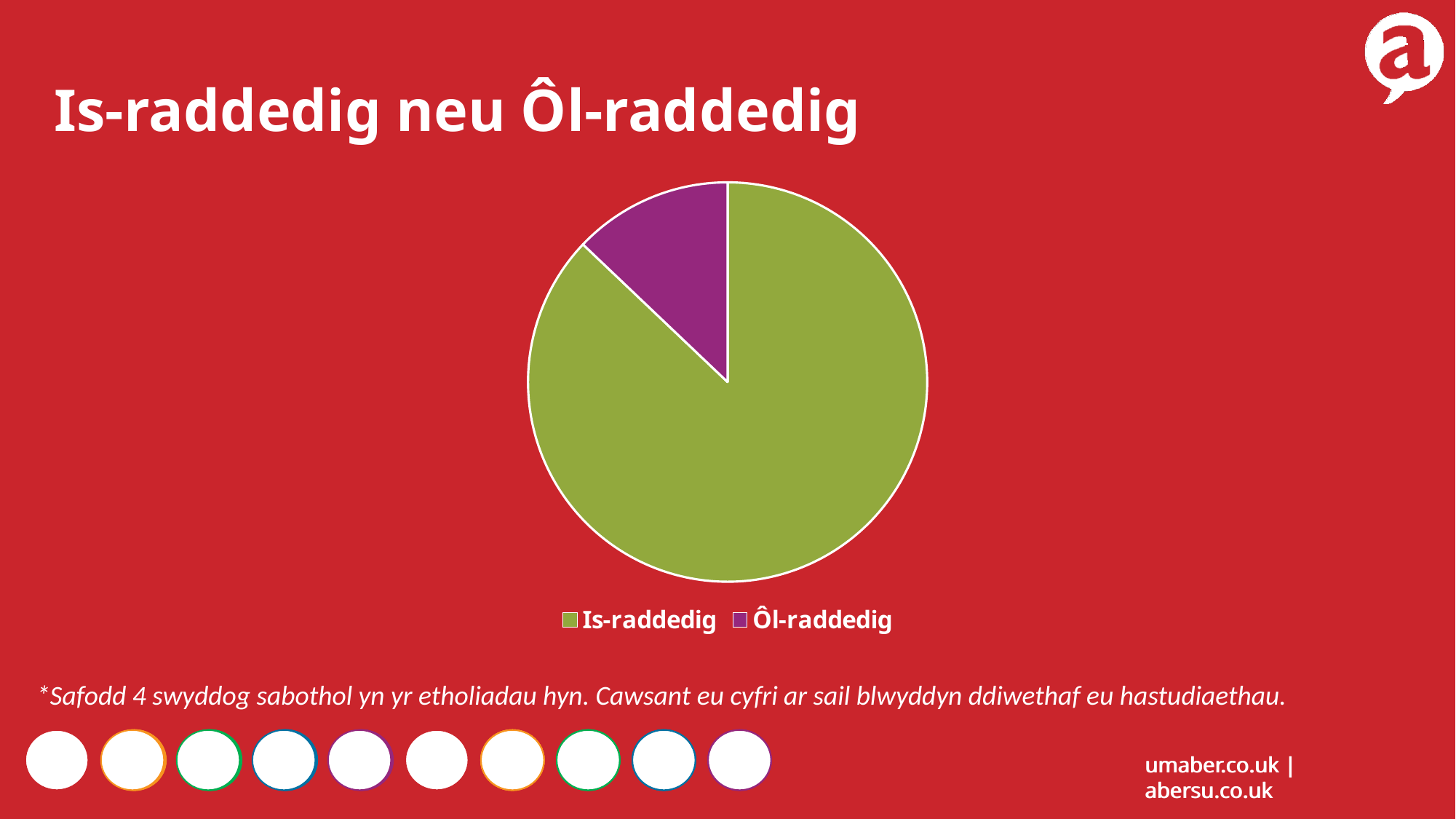
Which category has the largest slice of the pie chart? Is-raddedig How many entries does the legend of the pie chart list? 2 What kind of chart is shown on the slide? pie chart How many slices does the pie chart have? 2 Which slice is larger, Is-raddedig or Ôl-raddedig? Is-raddedig Which category has the smallest slice of the pie chart? Ôl-raddedig What is the title of the slide containing the pie chart? Is-raddedig neu Ôl-raddedig What colour is the Ôl-raddedig slice in the pie chart? purple